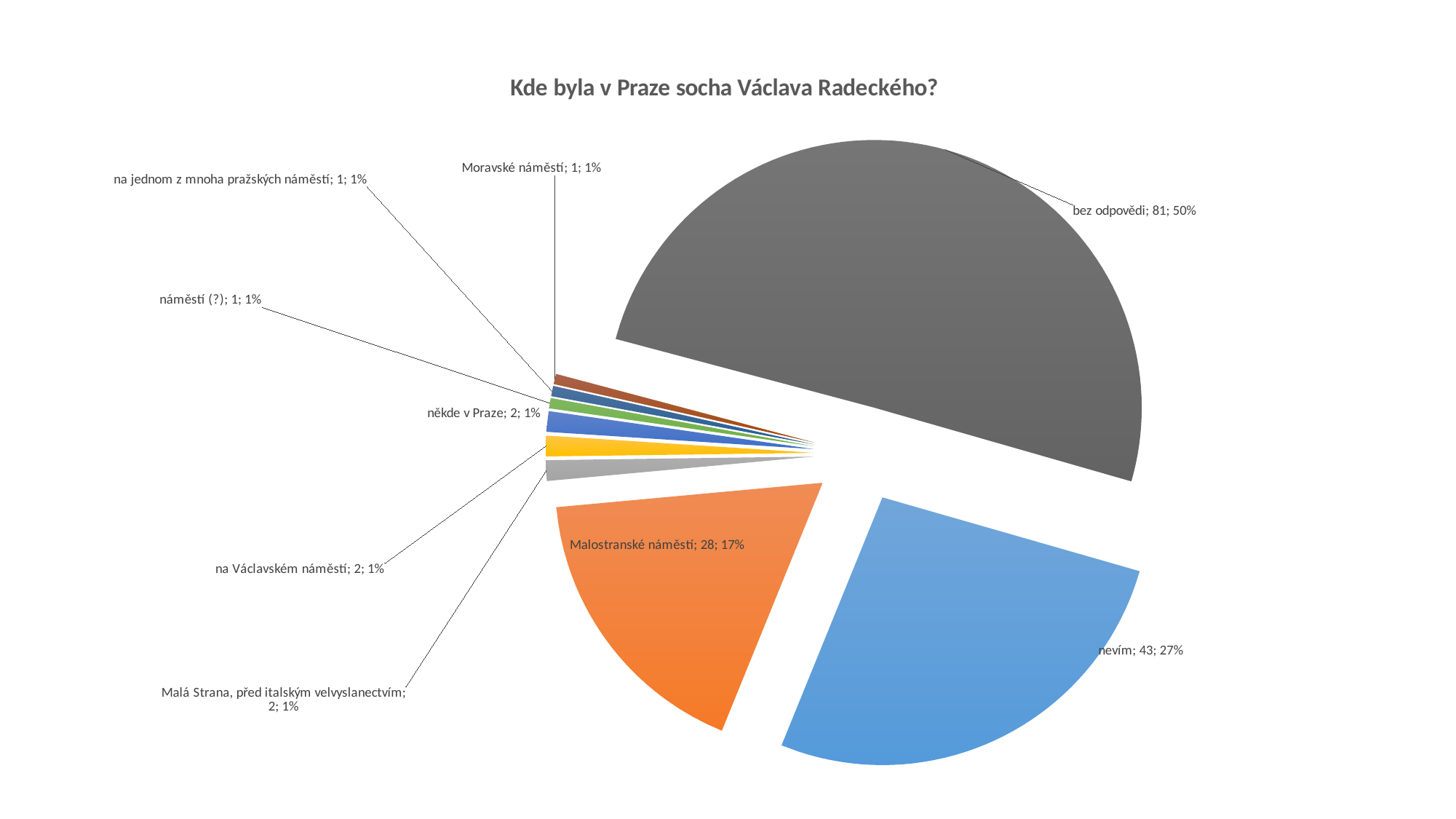
What kind of chart is shown on the slide? pie chart Which is larger, the count for "nevím" or the count for "Malostranské náměstí"? nevím What is the title of the chart? Kde byla v Praze socha Václava Radeckého? How many slices does the pie chart have? 9 What share of the pie does "Moravské náměstí" represent? 1% What share of the pie does "nevím" represent? 27% What is the difference between the counts for "bez odpovědi" and "nevím"? 38 What is the count for "bez odpovědi"? 81 What is the count for "na Václavském náměstí"? 2 Which category has the largest slice? bez odpovědi What share of the pie does "Malostranské náměstí" represent? 17% What is the count for "Malostranské náměstí"? 28